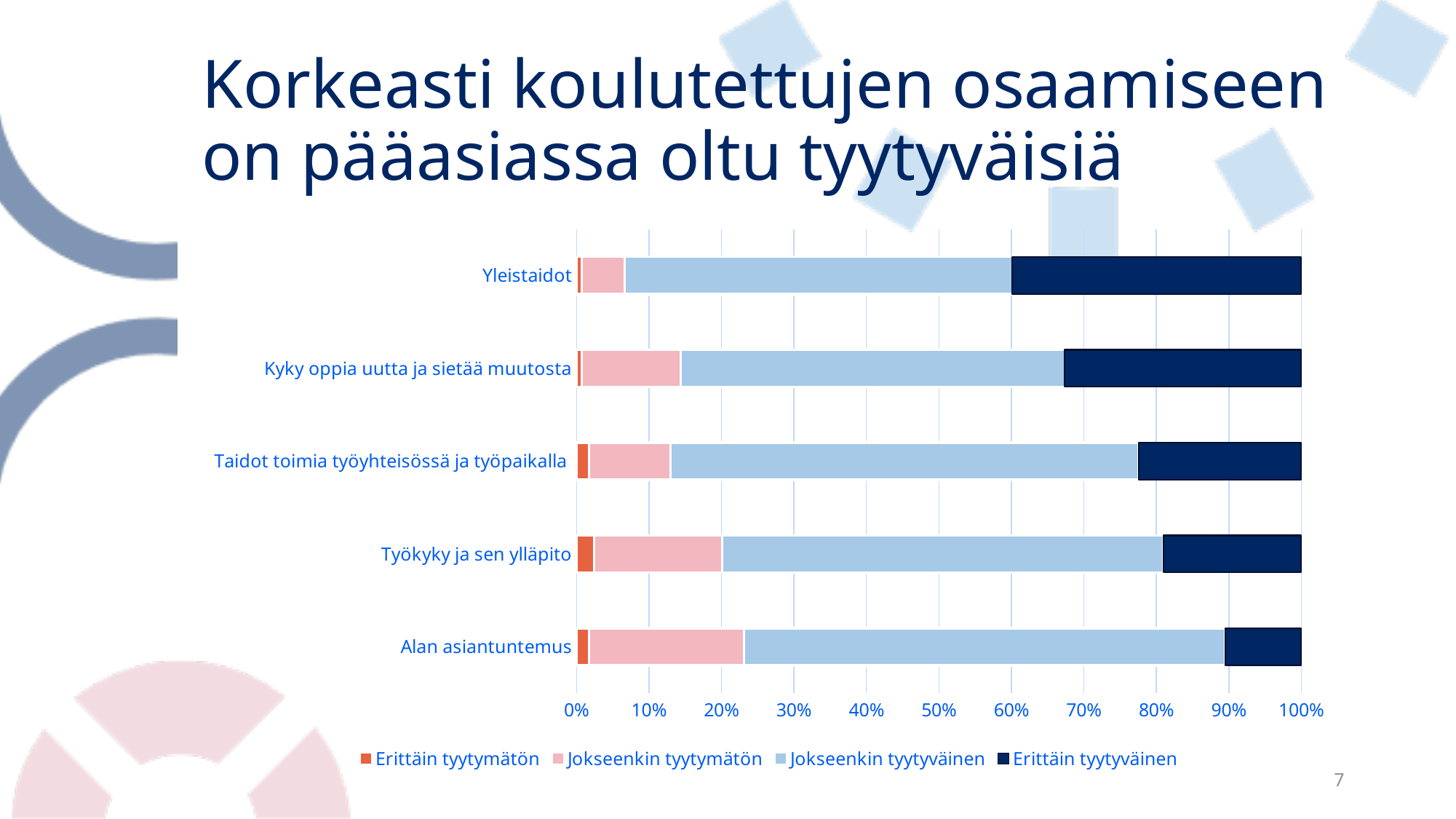
Which category has the smallest Erittäin tyytyväinen share? Alan asiantuntemus What kind of chart is shown on the slide? Stacked bar chart How many categories are plotted on the chart? 5 Is the Erittäin tyytyväinen value for Alan asiantuntemus greater or less than 20%? less What are the four legend entries of the chart? Erittäin tyytymätön, Jokseenkin tyytymätön, Jokseenkin tyytyväinen, Erittäin tyytyväinen What is the total of the stacked bar for Yleistaidot? 100% Is the Jokseenkin tyytymätön value for Alan asiantuntemus greater or less than 10%? greater How many series does the legend list? 4 Is the Erittäin tyytyväinen value for Yleistaidot greater or less than 30%? greater Which has the larger Erittäin tyytyväinen share, Työkyky ja sen ylläpito or Alan asiantuntemus? Työkyky ja sen ylläpito What is the title of the slide containing the chart? Korkeasti koulutettujen osaamiseen on pääasiassa oltu tyytyväisiä Which category has the largest Erittäin tyytyväinen share? Yleistaidot